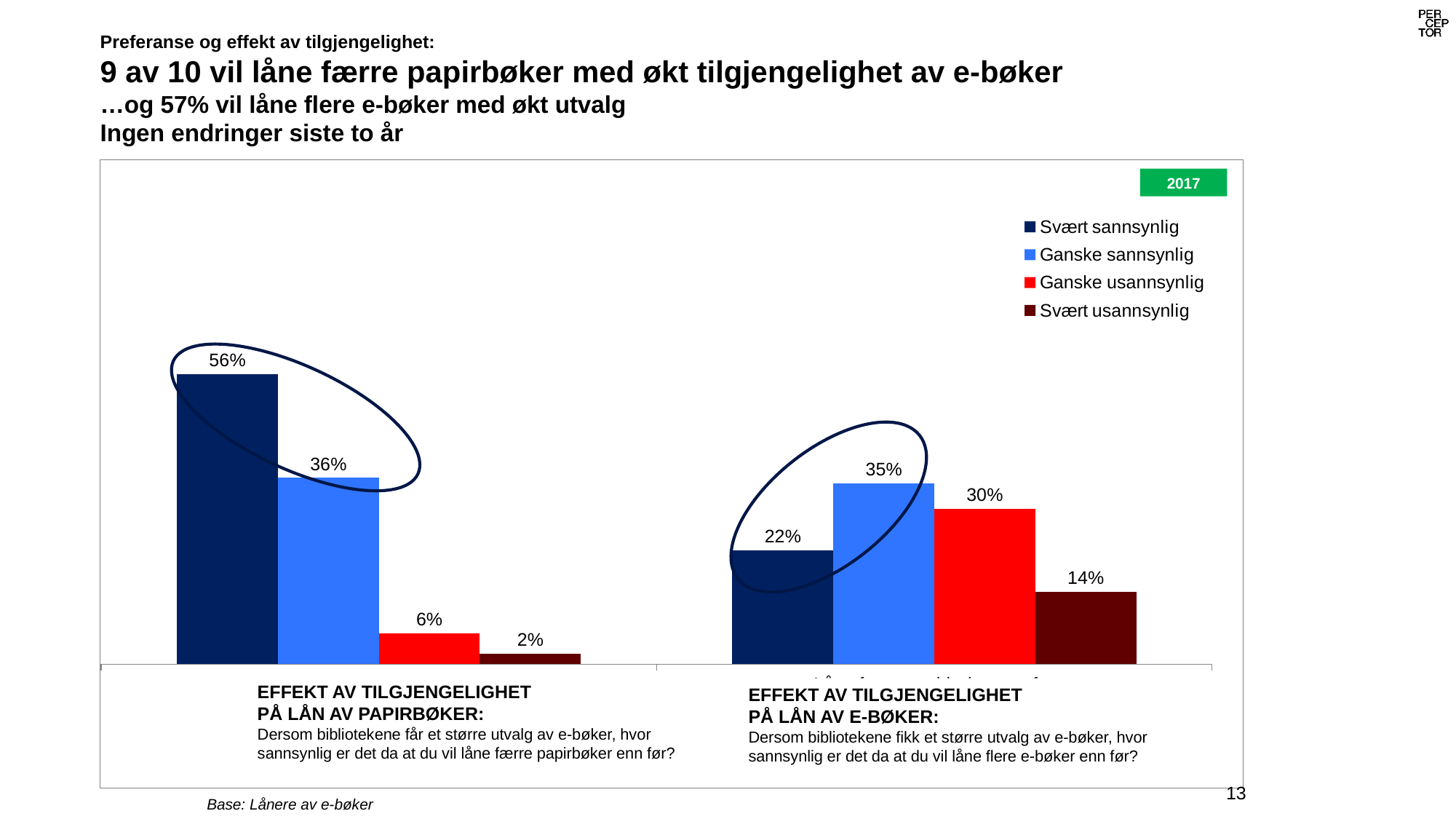
What is the difference between "Svært sannsynlig" and "Ganske sannsynlig" in the group "Effekt av tilgjengelighet på lån av papirbøker"? 20% What is the value for "Svært usannsynlig" in the group "Effekt av tilgjengelighet på lån av papirbøker"? 2% How many series does the legend list? 4 What is the value for "Ganske usannsynlig" in the group "Effekt av tilgjengelighet på lån av e-bøker"? 30% Which series has the lowest value in the group "Effekt av tilgjengelighet på lån av papirbøker"? Svært usannsynlig What is the difference between "Ganske usannsynlig" and "Svært usannsynlig" in the group "Effekt av tilgjengelighet på lån av e-bøker"? 16% What kind of chart is shown on the slide? Bar chart What is the value for "Svært sannsynlig" in the group "Effekt av tilgjengelighet på lån av papirbøker"? 56% Which is larger: "Svært sannsynlig" for papirbøker or "Svært sannsynlig" for e-bøker? Svært sannsynlig for papirbøker Which series has the highest value in the group "Effekt av tilgjengelighet på lån av e-bøker"? Ganske sannsynlig Which year is shown in the green label at the top right of the chart? 2017 What is the value for "Svært sannsynlig" in the group "Effekt av tilgjengelighet på lån av e-bøker"? 22%